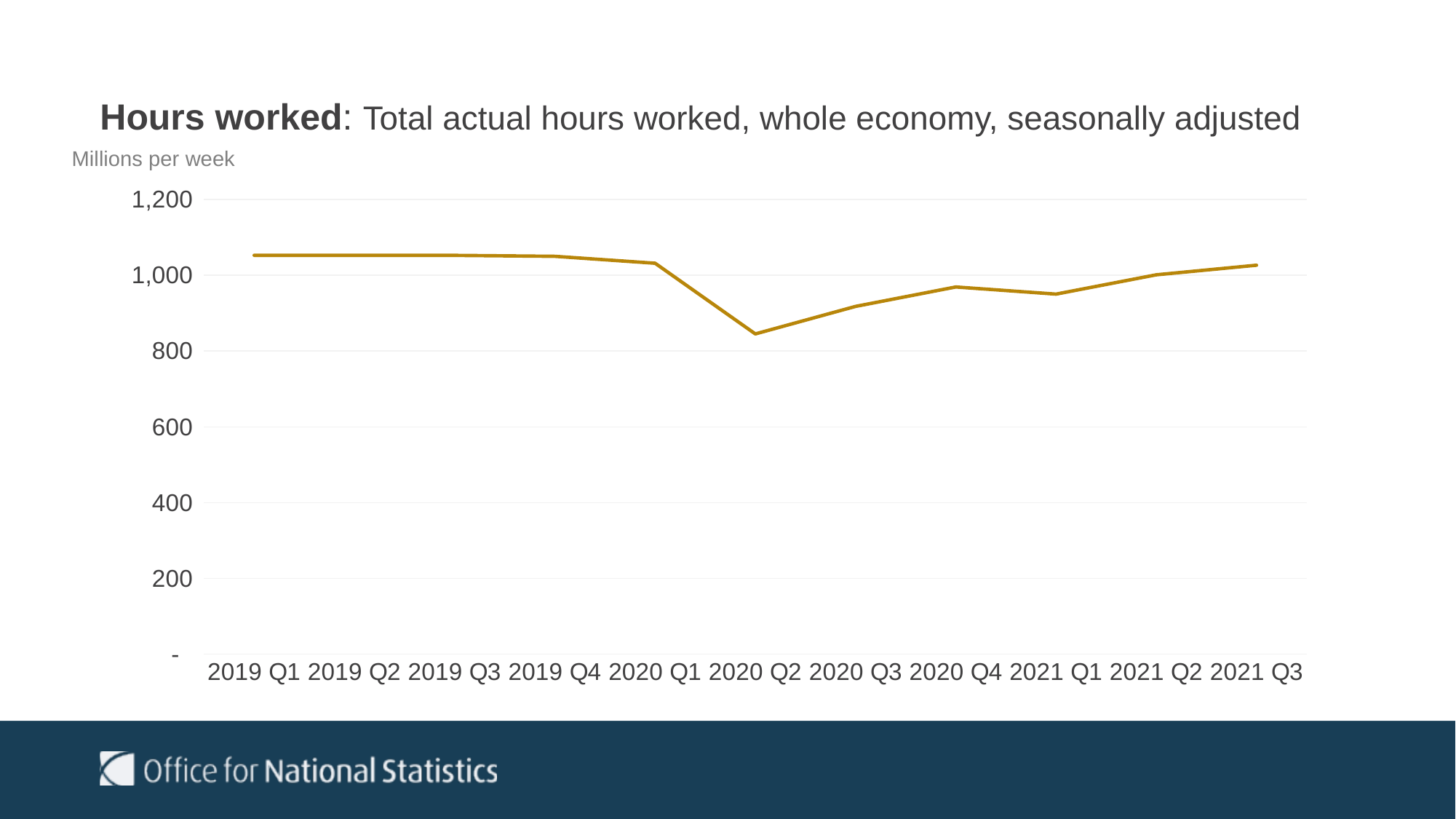
Which is larger, the value for 2020 Q2 or the value for 2020 Q4? 2020 Q4 What kind of chart is shown on the slide? line chart Is the value for 2021 Q1 greater or less than 1,000? less Is the value for 2020 Q2 greater or less than 800? greater What unit is given for the y axis of the chart? Millions per week Do the values rise or fall between 2020 Q2 and 2020 Q4? rise Which is larger, the value for 2019 Q1 or the value for 2021 Q1? 2019 Q1 Which quarter has the lowest total actual hours worked? 2020 Q2 Do the values rise or fall between 2019 Q4 and 2020 Q2? fall Is the value for 2020 Q2 greater or less than 1,000? less How many quarters are plotted along the x axis? 11